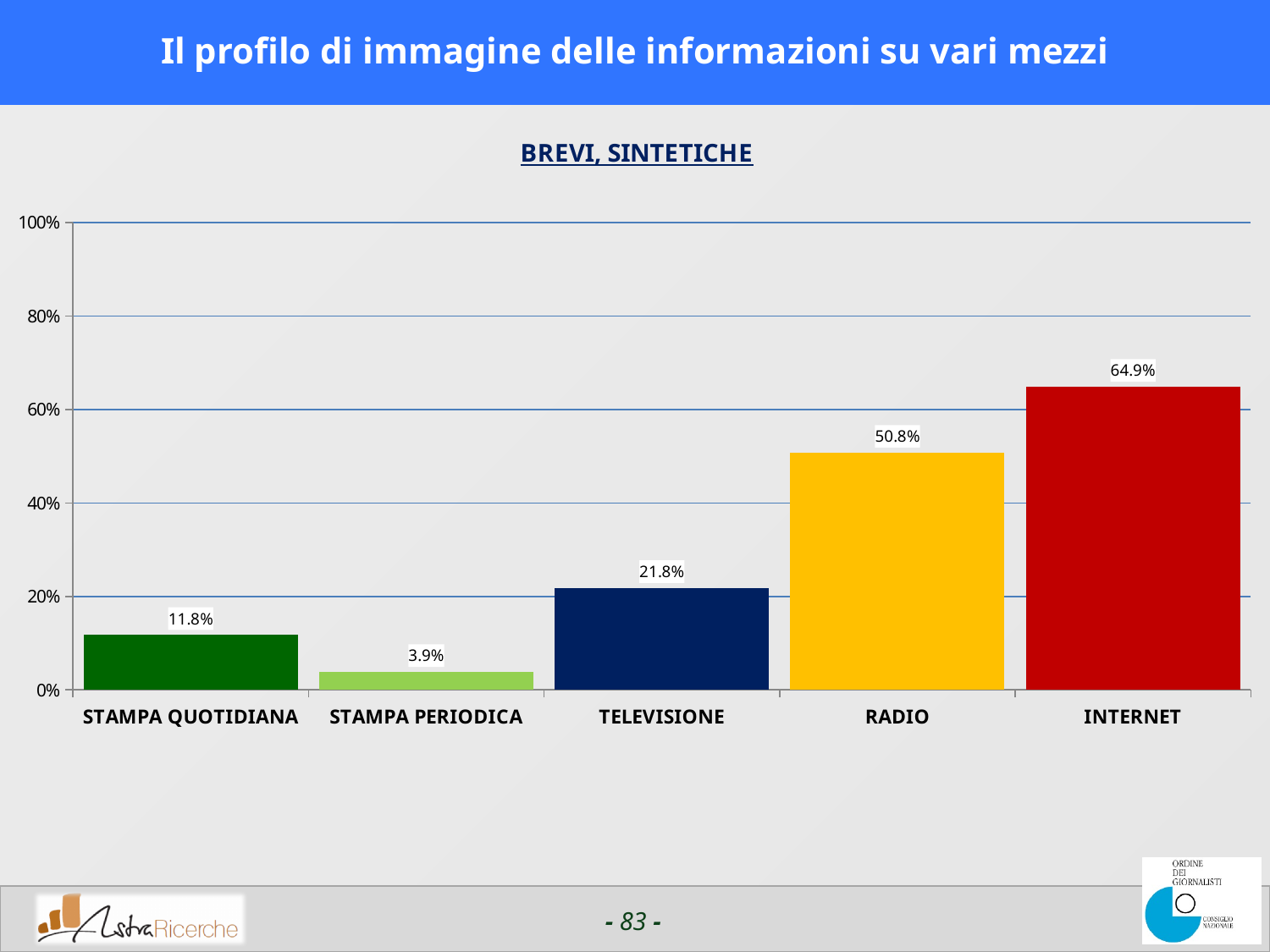
Is the value for RADIO greater or less than 40%? greater What is the difference between the values for TELEVISIONE and STAMPA QUOTIDIANA? 10.0% What is the difference between the values for INTERNET and RADIO? 14.1% What is the title shown above the chart? BREVI, SINTETICHE Which is larger, the value for TELEVISIONE or the value for STAMPA QUOTIDIANA? TELEVISIONE How many categories are shown on the x axis? 5 Which category has the lowest value? STAMPA PERIODICA Which category has the highest value? INTERNET What is the value for RADIO? 50.8% What is the value for INTERNET? 64.9% What kind of chart is shown on the slide? bar chart What is the value for STAMPA PERIODICA? 3.9%